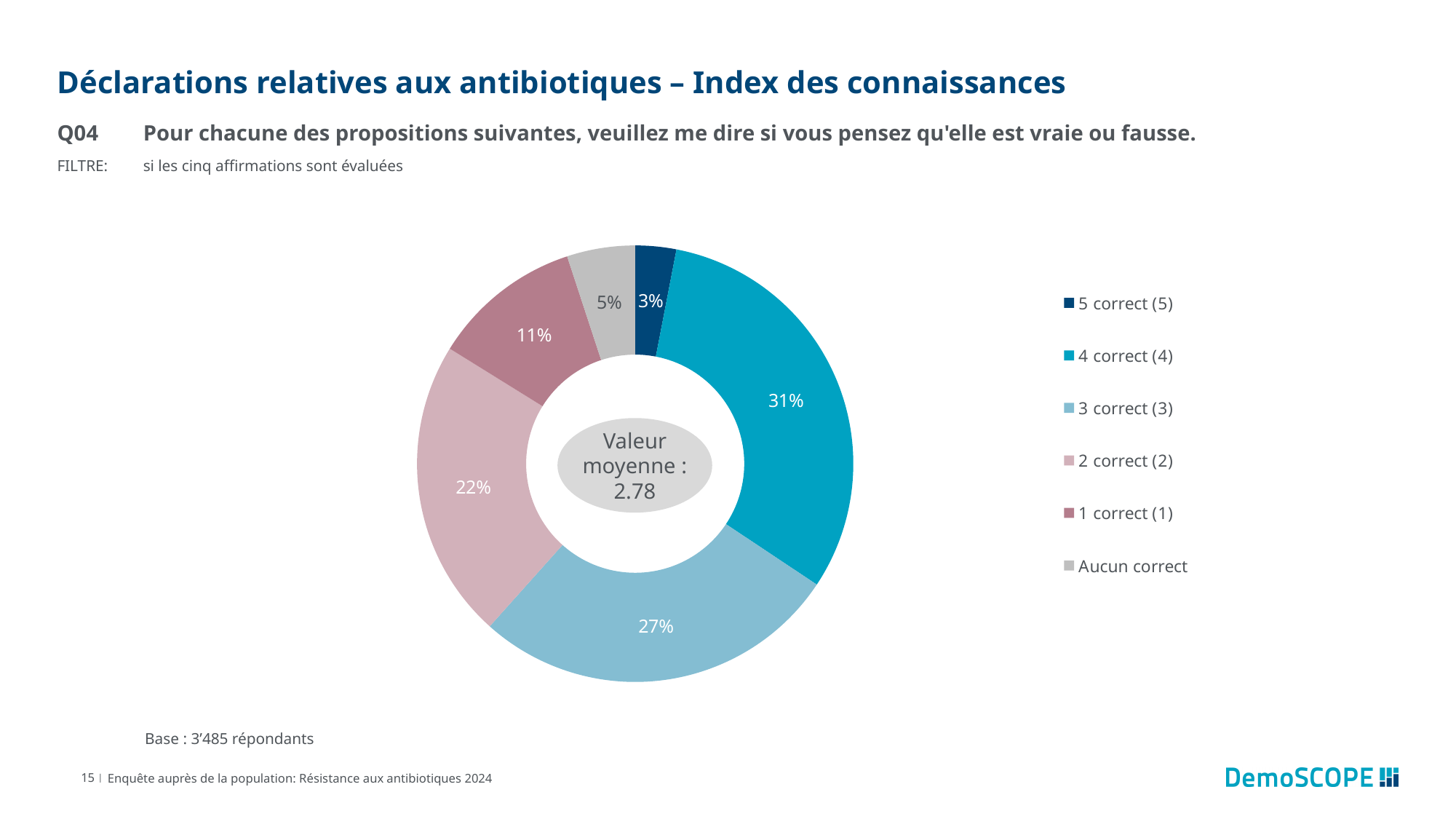
Which category has the largest share of the chart? 4 correct (4) Which category has the smallest share of the chart? 5 correct (5) What share of respondents got 4 correct (4)? 31% What is the 'Valeur moyenne' shown in the centre of the chart? 2.78 Which is larger, the share for 3 correct (3) or the share for 1 correct (1)? 3 correct (3) What is the difference in percentage points between the 4 correct (4) and 2 correct (2) shares? 9 What share of respondents fall in the 'Aucun correct' category? 5% What share of respondents got 2 correct (2)? 22% What share of respondents got 1 correct (1)? 11% How many categories does the legend list? 6 What share of respondents got 3 correct (3)? 27% What share of respondents got 5 correct (5)? 3%